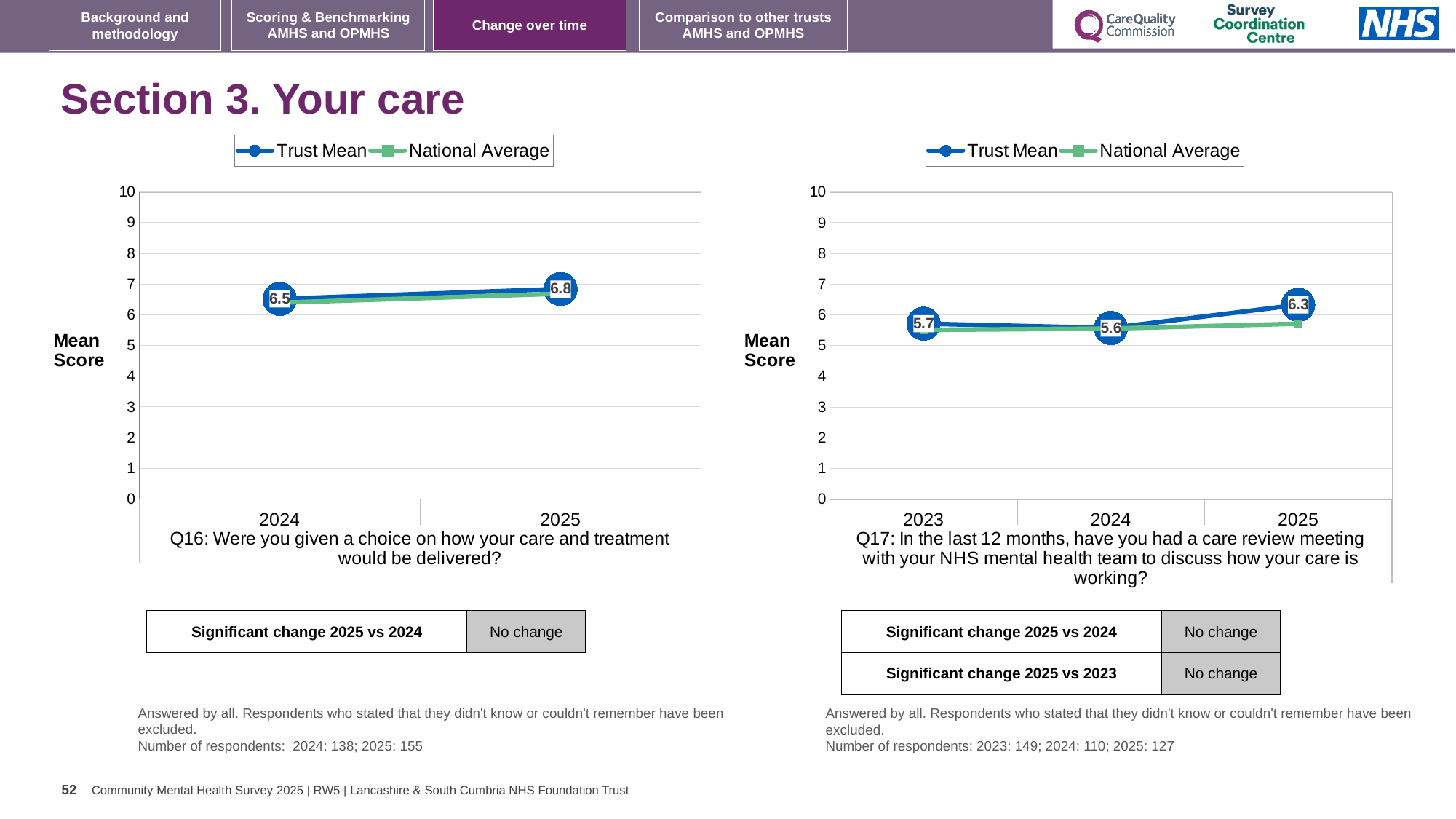
How many years are shown on the x axis of the Q17 chart (right)? 3 On the Q16 chart (left), what is the Trust Mean for 2025? 6.8 How many series does the legend of the Q16 chart (left) list? 2 On the Q16 chart (left), what is the Trust Mean for 2024? 6.5 On the Q17 chart (right), what is the Trust Mean for 2023? 5.7 On the Q17 chart (right), which year has the highest Trust Mean? 2025 On the Q16 chart (left), what is the difference between the Trust Mean for 2025 and 2024? 0.3 On the Q17 chart (right), what is the difference between the Trust Mean for 2025 and 2024? 0.7 On the Q17 chart (right), what is the Trust Mean for 2025? 6.3 On the Q17 chart (right), is the Trust Mean for 2025 greater or less than 6? greater What type of chart is used for Q16 (left)? Line chart On the Q17 chart (right), which year has the lowest Trust Mean? 2024